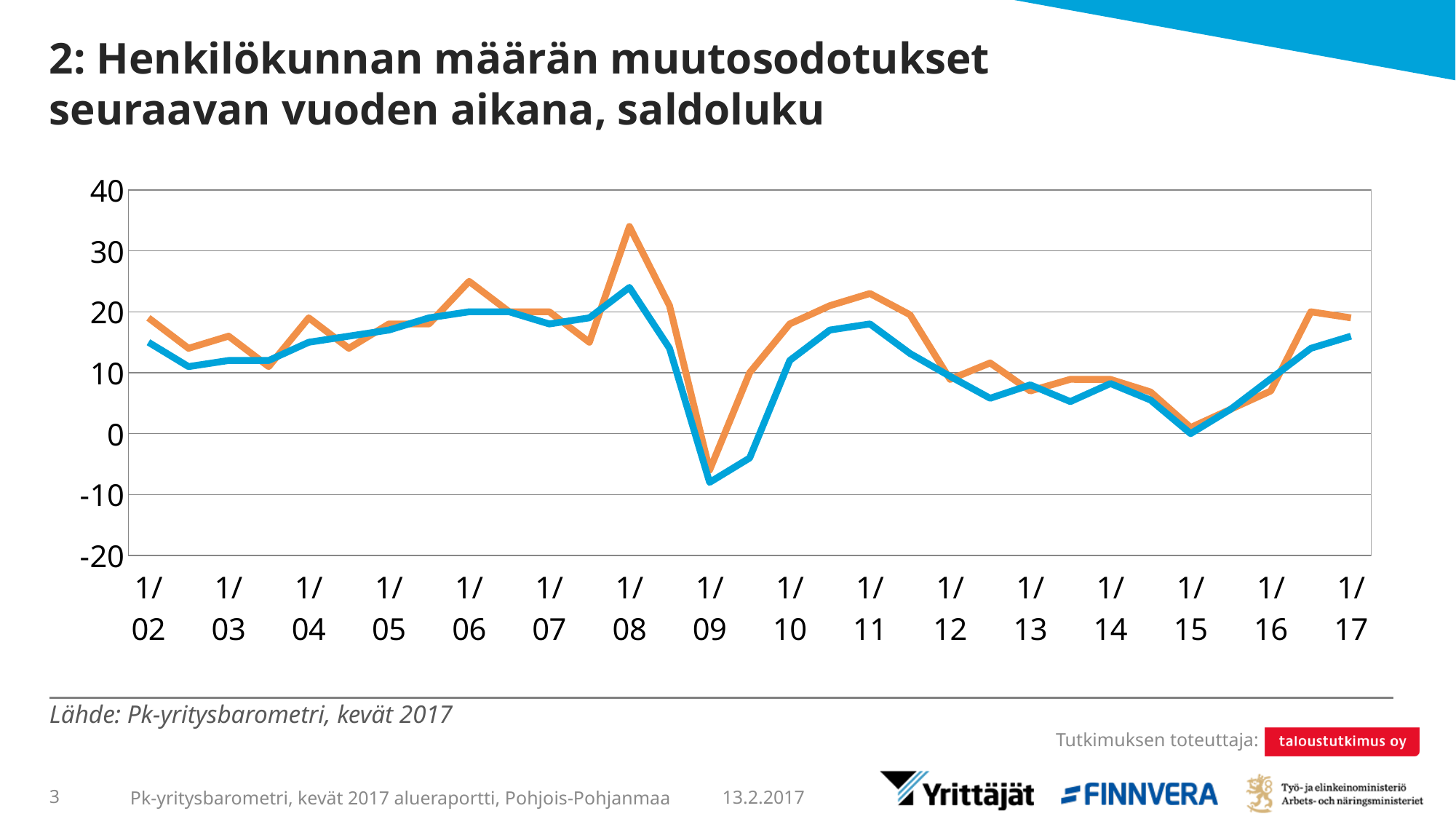
Do the lines rise or fall between 1/15 and 1/17? rise Is the value of the blue line at 1/09 greater or less than 0? less At which x-axis label does the orange line reach its highest value? 1/08 At which x-axis label does the blue line reach its lowest value? 1/09 How many labelled points are there on the x axis? 16 What is the lowest value shown on the y axis? -20 What kind of chart is shown on the slide? line chart At 1/11, which line has the higher value, the orange or the blue? orange How many lines are plotted on the chart? 2 At 1/08, which line has the higher value, the orange or the blue? orange Is the value of the orange line at 1/06 greater or less than 20? greater Is the value of the orange line at 1/08 greater or less than 30? greater